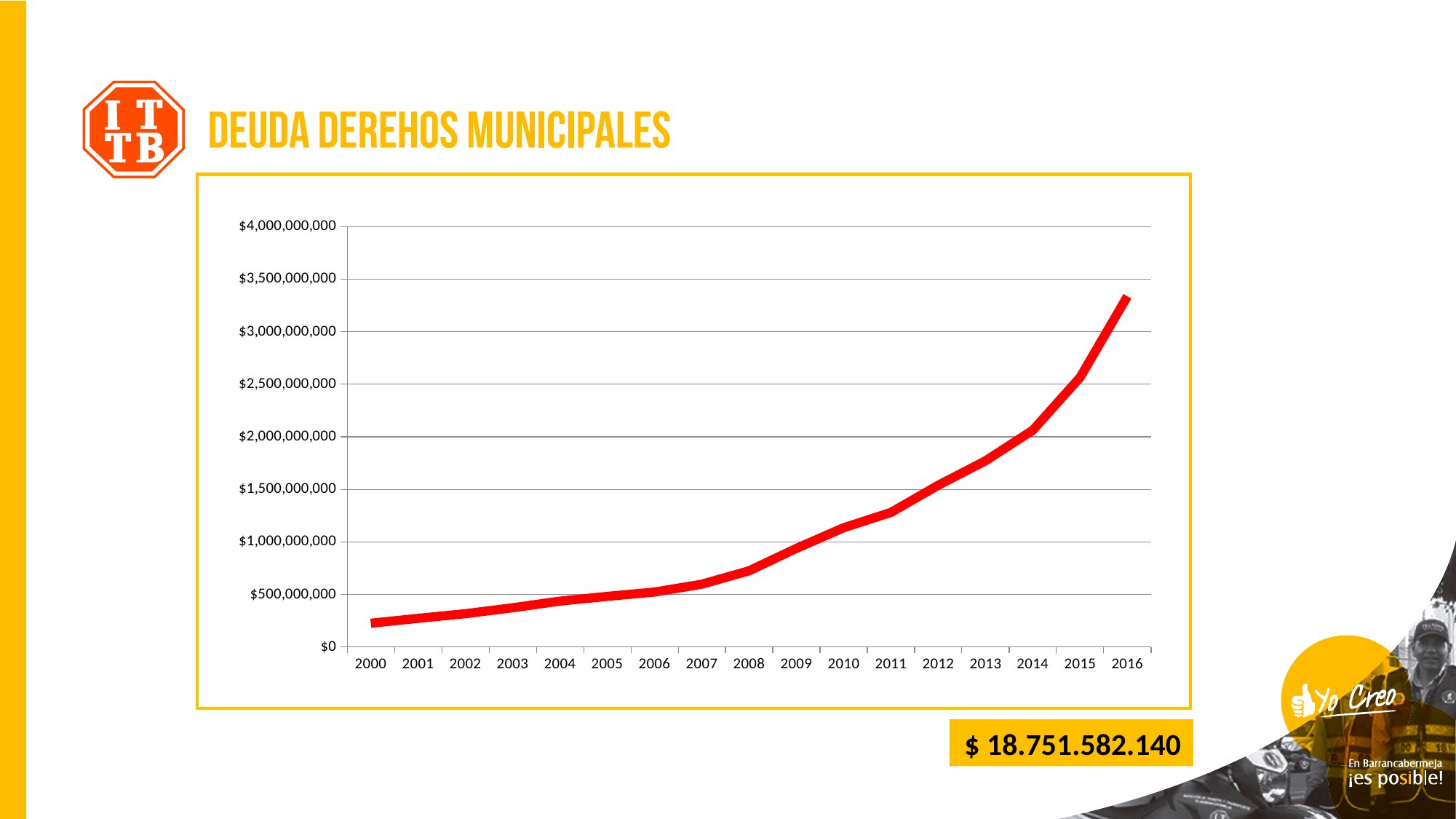
What is the title of the slide containing the chart? DEUDA DEREHOS MUNICIPALES Which year has the highest value on the chart? 2016 Is the value for 2010 greater or less than $1,000,000,000? greater What kind of chart is shown on the slide? line chart Is the value for 2000 greater or less than $500,000,000? less Is the value for 2016 greater or less than $3,000,000,000? greater Do the values rise or fall from 2000 to 2016? rise Which year has the lowest value on the chart? 2000 Which year has the larger value, 2005 or 2010? 2010 How many years are plotted along the x axis of the chart? 17 What colour is the line plotted on the chart? red